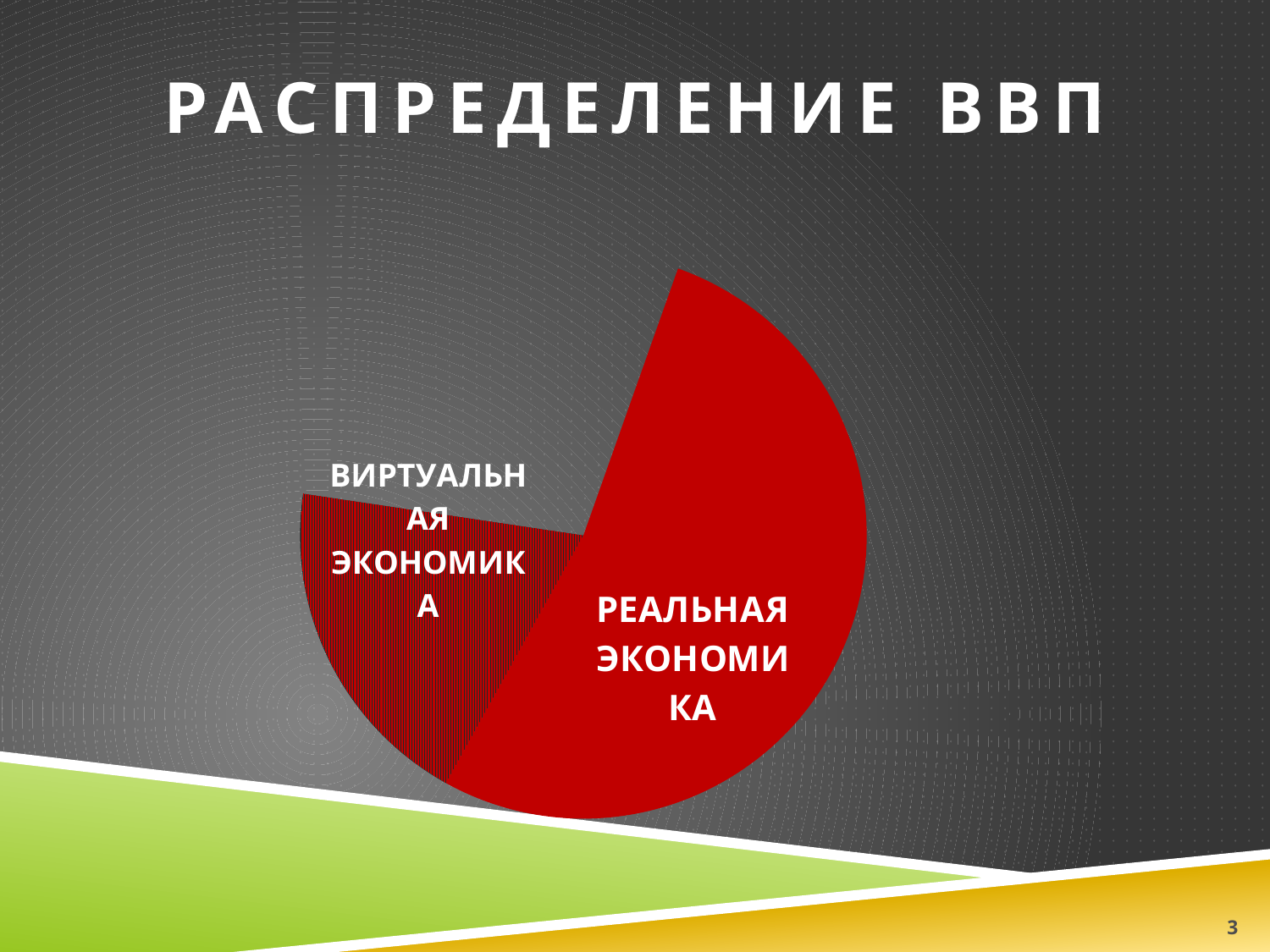
What is the title of the slide containing the pie chart? РАСПРЕДЕЛЕНИЕ ВВП Which is larger in the pie chart: ВИРТУАЛЬНАЯ ЭКОНОМИКА or РЕАЛЬНАЯ ЭКОНОМИКА? РЕАЛЬНАЯ ЭКОНОМИКА What kind of chart is shown on the slide? Pie chart Which slice of the pie chart is drawn with a hatched (striped) pattern? ВИРТУАЛЬНАЯ ЭКОНОМИКА Which slice of the pie chart is the largest? РЕАЛЬНАЯ ЭКОНОМИКА Which slice of the pie chart is the smallest? ВИРТУАЛЬНАЯ ЭКОНОМИКА